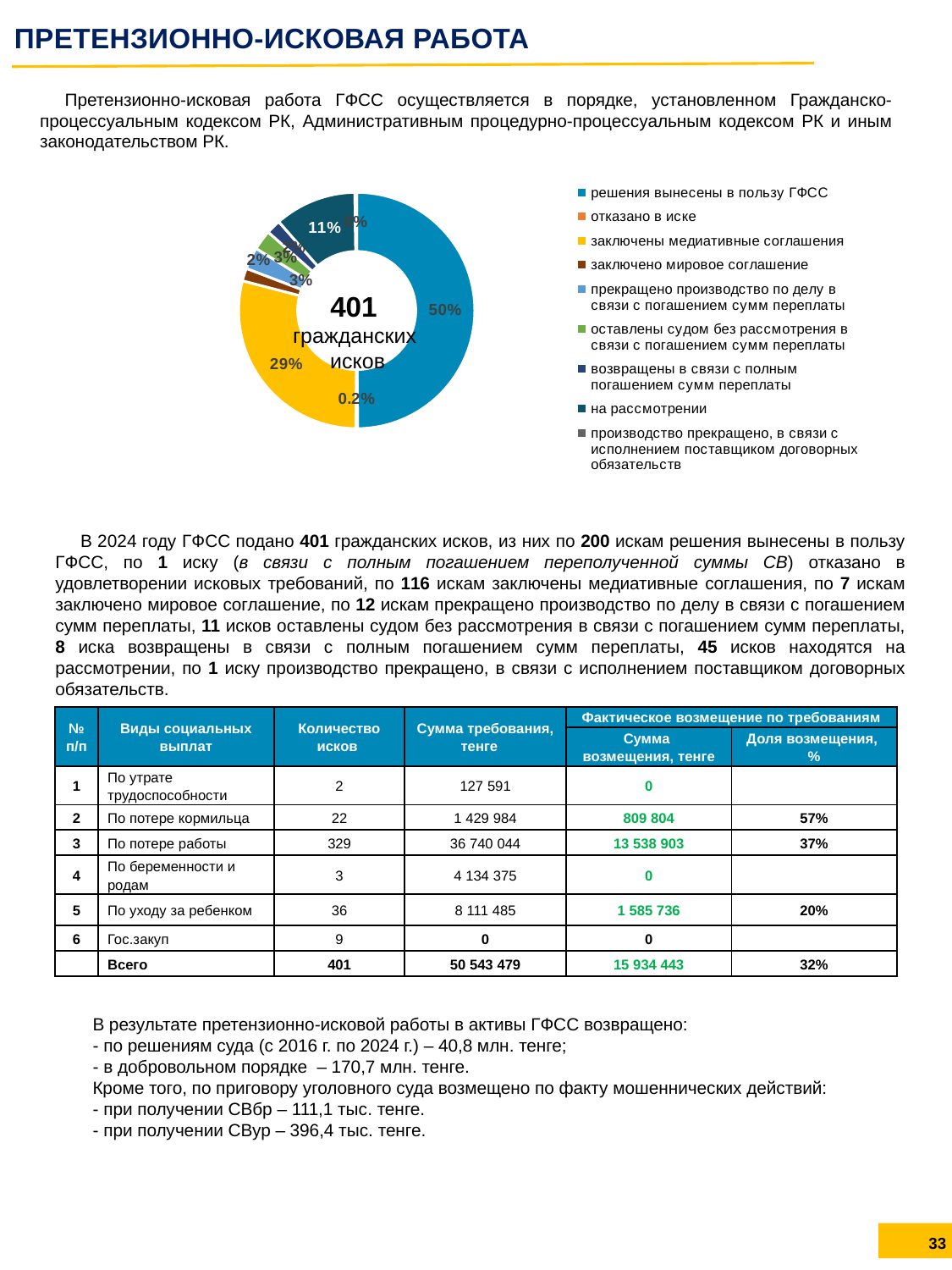
What share of the chart is labelled for 'решения вынесены в пользу ГФСС'? 50% What kind of chart is shown on the slide? Doughnut (pie) chart Which slice is larger: 'на рассмотрении' or 'отказано в иске'? на рассмотрении Which category has the largest slice in the chart? решения вынесены в пользу ГФСС What share of the chart is labelled for 'отказано в иске'? 0.2% What share of the chart is labelled for 'заключены медиативные соглашения'? 29% What number is printed in the centre of the doughnut chart? 401 By how many percentage points does the 'решения вынесены в пользу ГФСС' slice (50%) exceed the 'заключены медиативные соглашения' slice (29%)? 21 percentage points How many entries does the chart legend list? 9 What share of the chart is labelled for 'на рассмотрении'? 11% Which slice is larger: 'решения вынесены в пользу ГФСС' or 'заключены медиативные соглашения'? решения вынесены в пользу ГФСС What text accompanies the number in the centre of the doughnut chart? гражданских исков